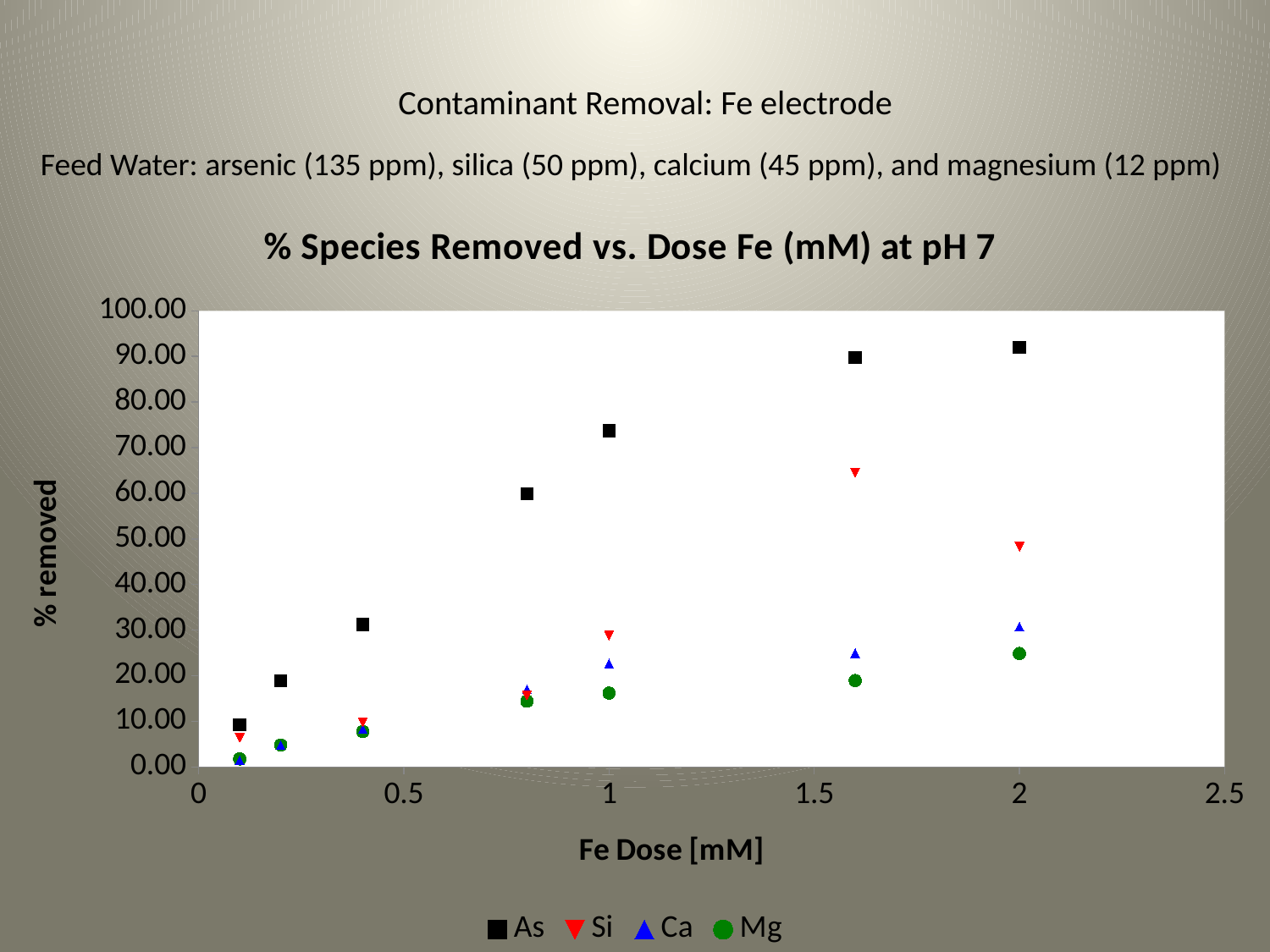
What is the label of the x axis? Fe Dose [mM] Is the value for Si at an Fe dose of 1.6 mM greater or less than 60? greater Is the value for Mg at an Fe dose of 2 mM greater or less than 30? less Is the value for As at an Fe dose of 1 mM greater or less than 70? greater What kind of chart is shown on the slide? scatter chart Does the % removed for As rise or fall as the Fe dose increases? rise What is the title of the chart? % Species Removed vs. Dose Fe (mM) at pH 7 How many series does the legend list? 4 At an Fe dose of 1.6 mM, which series has the higher % removed, Si or Mg? Si At an Fe dose of 2 mM, which series has the higher % removed, As or Si? As